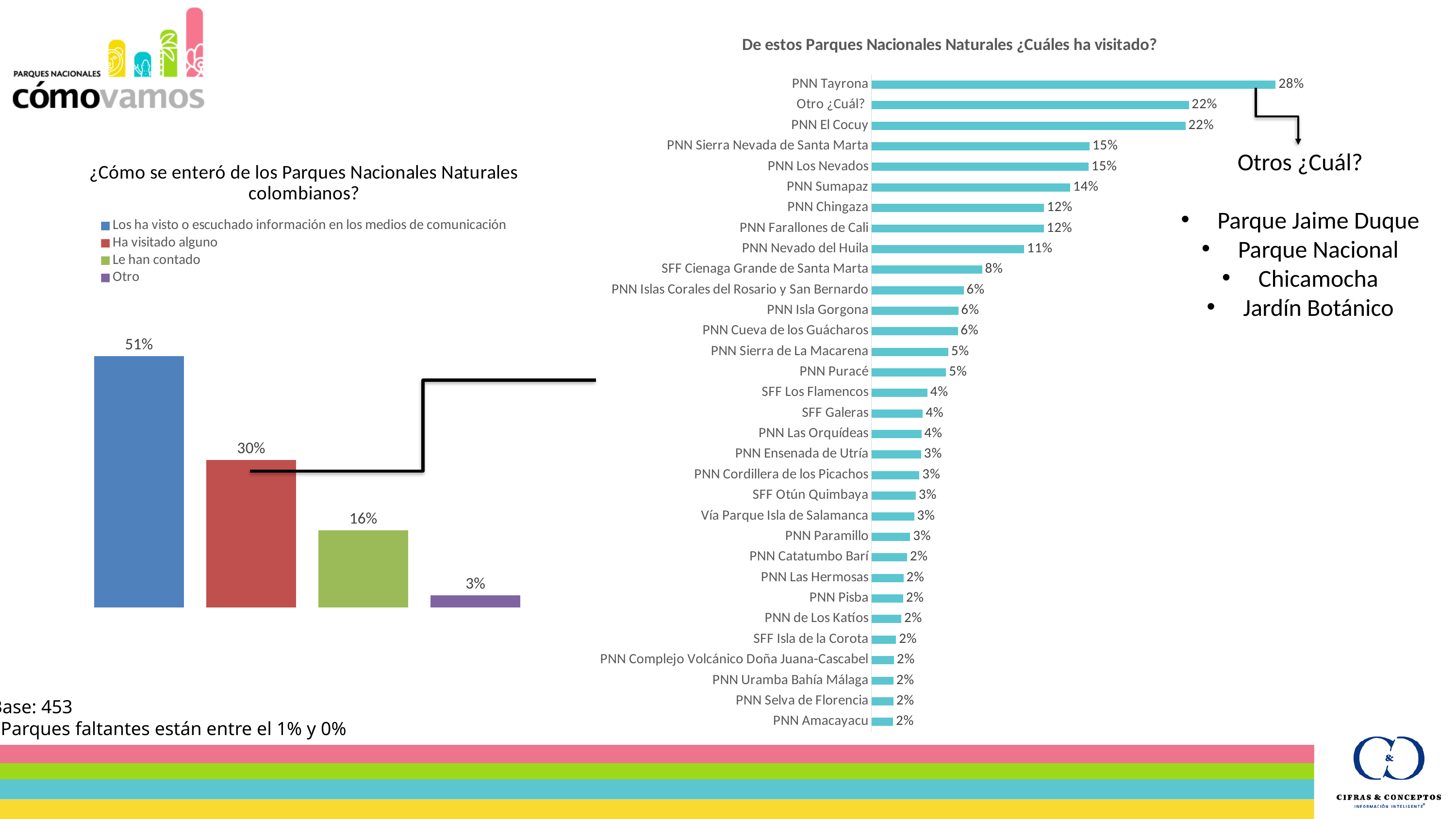
In the chart 'De estos Parques Nacionales Naturales ¿Cuáles ha visitado?', what is the difference between PNN Tayrona and PNN El Cocuy? 6% How many entries does the legend of the chart '¿Cómo se enteró de los Parques Nacionales Naturales colombianos?' list? 4 In the chart '¿Cómo se enteró de los Parques Nacionales Naturales colombianos?', what is the value for 'Ha visitado alguno'? 30% What kind of chart is 'De estos Parques Nacionales Naturales ¿Cuáles ha visitado?'? Bar chart In the chart '¿Cómo se enteró de los Parques Nacionales Naturales colombianos?', which category has the highest value? Los ha visto o escuchado información en los medios de comunicación How many categories are shown in the chart 'De estos Parques Nacionales Naturales ¿Cuáles ha visitado?'? 32 In the chart '¿Cómo se enteró de los Parques Nacionales Naturales colombianos?', what is the difference between 'Los ha visto o escuchado información en los medios de comunicación' and 'Le han contado'? 35% In the chart 'De estos Parques Nacionales Naturales ¿Cuáles ha visitado?', what is the value for PNN Tayrona? 28% In the chart '¿Cómo se enteró de los Parques Nacionales Naturales colombianos?', which category has the lowest value? Otro In the chart 'De estos Parques Nacionales Naturales ¿Cuáles ha visitado?', what is the value for PNN Sumapaz? 14% In the chart 'De estos Parques Nacionales Naturales ¿Cuáles ha visitado?', which park has the highest value? PNN Tayrona In the chart 'De estos Parques Nacionales Naturales ¿Cuáles ha visitado?', which is larger: PNN Chingaza or SFF Cienaga Grande de Santa Marta? PNN Chingaza